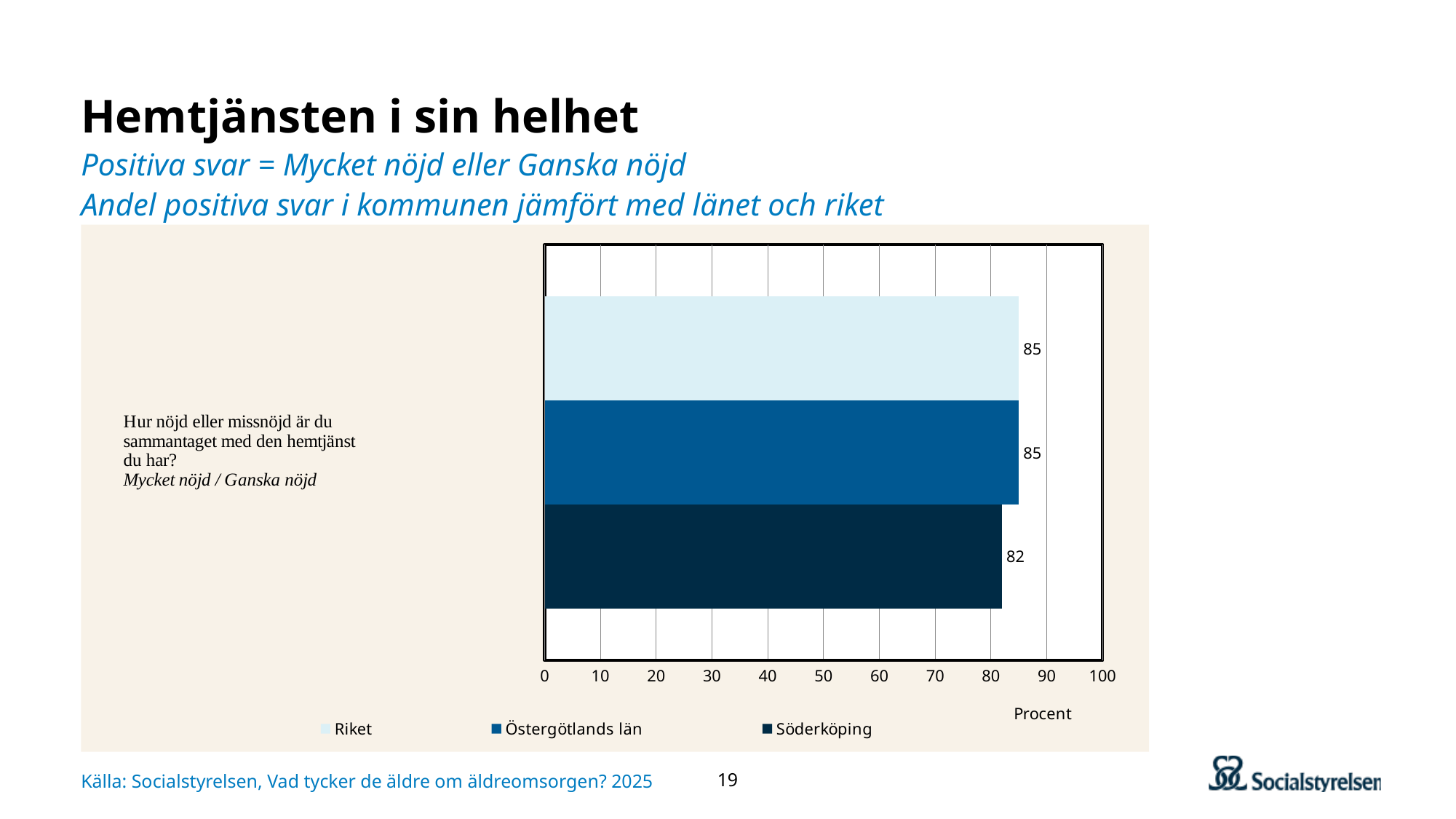
What is the value for Östergötlands län? 85 What unit is shown on the x axis of the chart? Procent Which series has the lowest value? Söderköping What kind of chart is shown on the slide? bar chart Is the value for Söderköping greater or less than 90? less Which is larger, the value for Östergötlands län or the value for Söderköping? Östergötlands län What is the maximum value shown on the x axis? 100 Is the value for Riket greater or less than 80? greater What is the value for Söderköping? 82 What is the difference between the values for Riket and Söderköping? 3 How many series does the legend list? 3 What is the value for Riket? 85